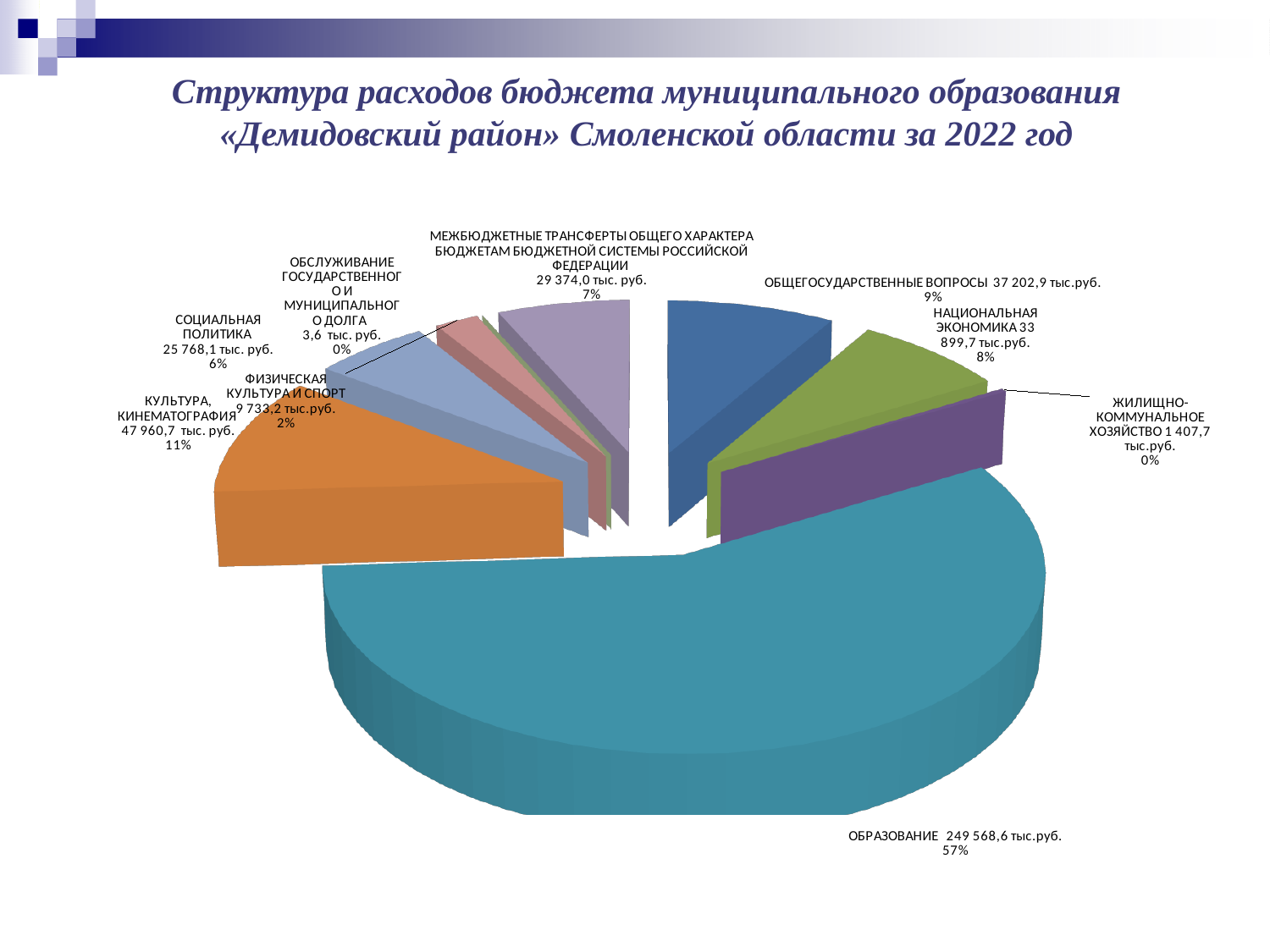
What is the expenditure value for НАЦИОНАЛЬНАЯ ЭКОНОМИКА? 33 899,7 тыс.руб. What is the expenditure value for КУЛЬТУРА, КИНЕМАТОГРАФИЯ? 47 960,7 тыс. руб. Which category has the largest share of the budget expenditures? ОБРАЗОВАНИЕ What is the title of the chart on the slide? Структура расходов бюджета муниципального образования «Демидовский район» Смоленской области за 2022 год What kind of chart is shown on the slide? pie chart Which category has the smallest expenditure value? ОБСЛУЖИВАНИЕ ГОСУДАРСТВЕННОГО И МУНИЦИПАЛЬНОГО ДОЛГА Which is larger: the expenditure for ОБЩЕГОСУДАРСТВЕННЫЕ ВОПРОСЫ or for МЕЖБЮДЖЕТНЫЕ ТРАНСФЕРТЫ ОБЩЕГО ХАРАКТЕРА? ОБЩЕГОСУДАРСТВЕННЫЕ ВОПРОСЫ What share of the pie does СОЦИАЛЬНАЯ ПОЛИТИКА represent? 6% How many categories (slices) does the pie chart show? 9 What is the difference between the expenditure for КУЛЬТУРА, КИНЕМАТОГРАФИЯ and for ОБЩЕГОСУДАРСТВЕННЫЕ ВОПРОСЫ? 10 757,8 тыс. руб. What is the expenditure value for ОБРАЗОВАНИЕ? 249 568,6 тыс.руб. What share of the pie does ОБРАЗОВАНИЕ represent? 57%